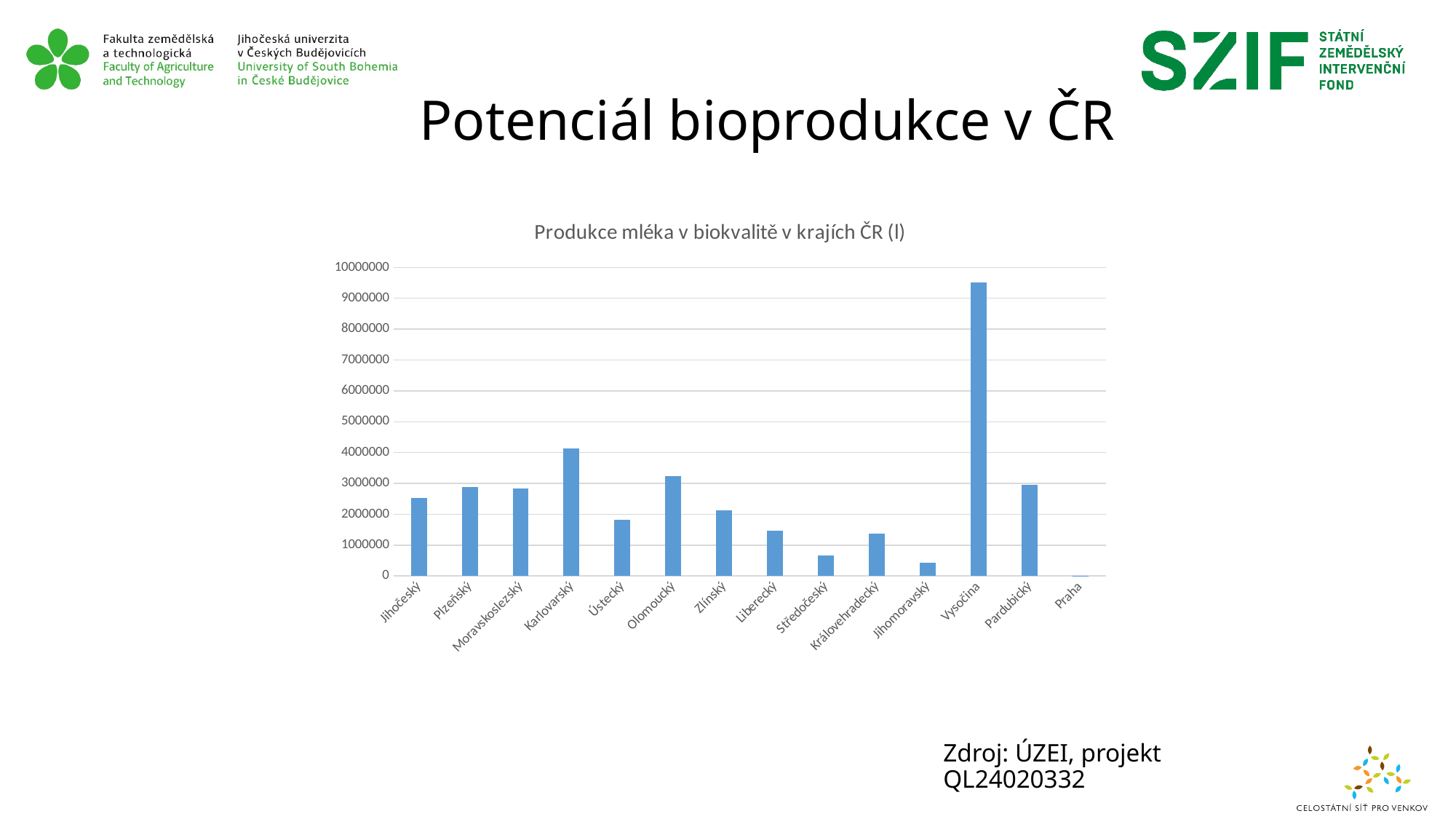
What is the title of the chart? Produkce mléka v biokvalitě v krajích ČR (l) What kind of chart is shown on the slide? bar chart How many regions (categories) are shown on the x axis of the chart? 14 Which region has the lowest value in the chart? Praha Which has the larger value, Pardubický or Jihočeský? Pardubický Is the value for Vysočina greater or less than 9000000? greater Is the value for Jihočeský greater or less than 2000000? greater Is the value for Jihomoravský greater or less than 1000000? less Which has the larger value, Karlovarský or Olomoucký? Karlovarský Which region has the highest value in the chart? Vysočina